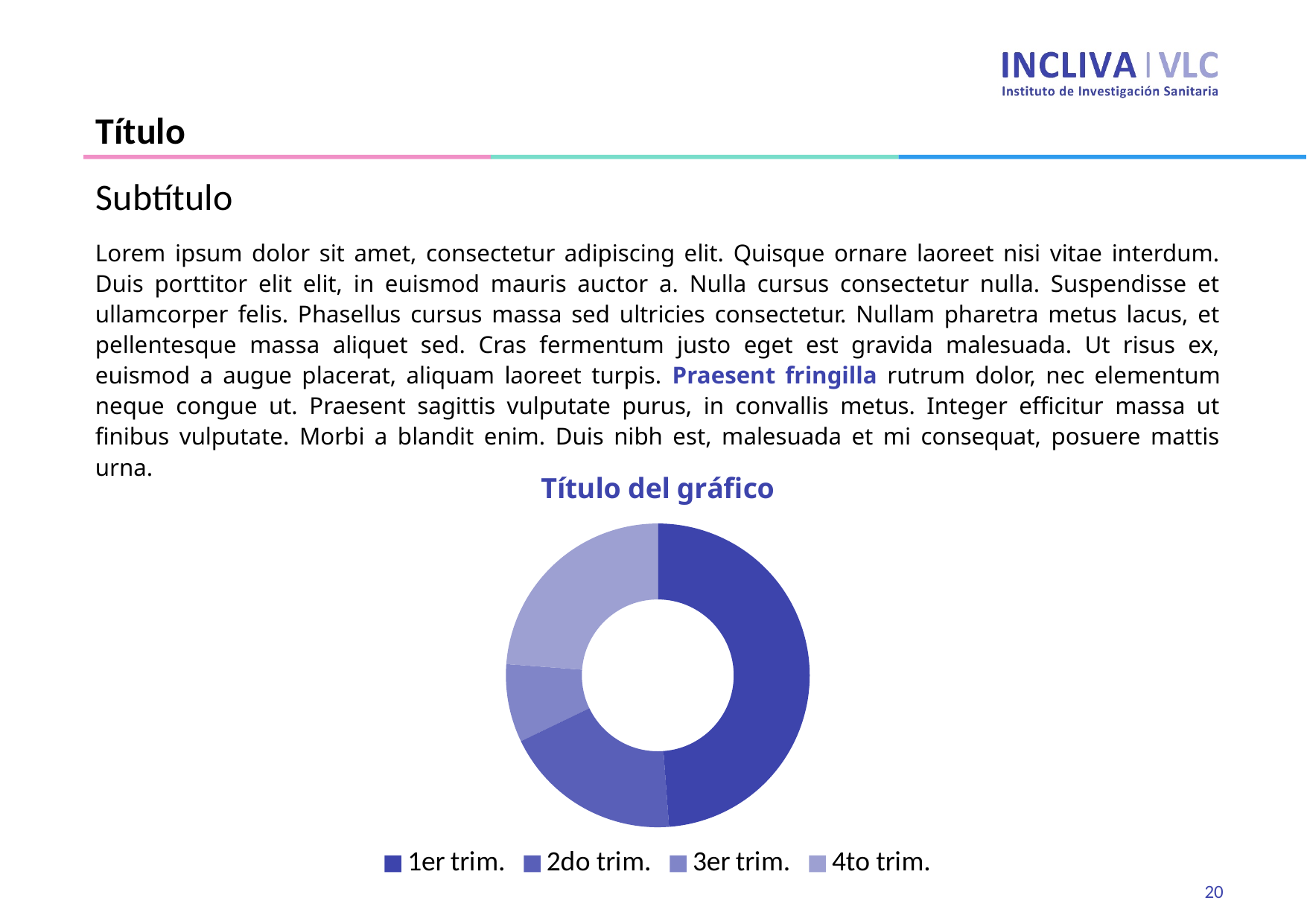
Which slice is larger, 1er trim. or 2do trim.? 1er trim. Which category has the smallest slice in the chart? 3er trim. Which slice is larger, 4to trim. or 3er trim.? 4to trim. Which category has the largest slice in the chart? 1er trim. What kind of chart is shown on the slide? Doughnut chart How many categories does the chart show? 4 How many entries does the chart legend list? 4 What is the title of the chart? Título del gráfico What is the first category listed in the chart legend? 1er trim. What is the last category listed in the chart legend? 4to trim. Which slice is larger, 1er trim. or 4to trim.? 1er trim.